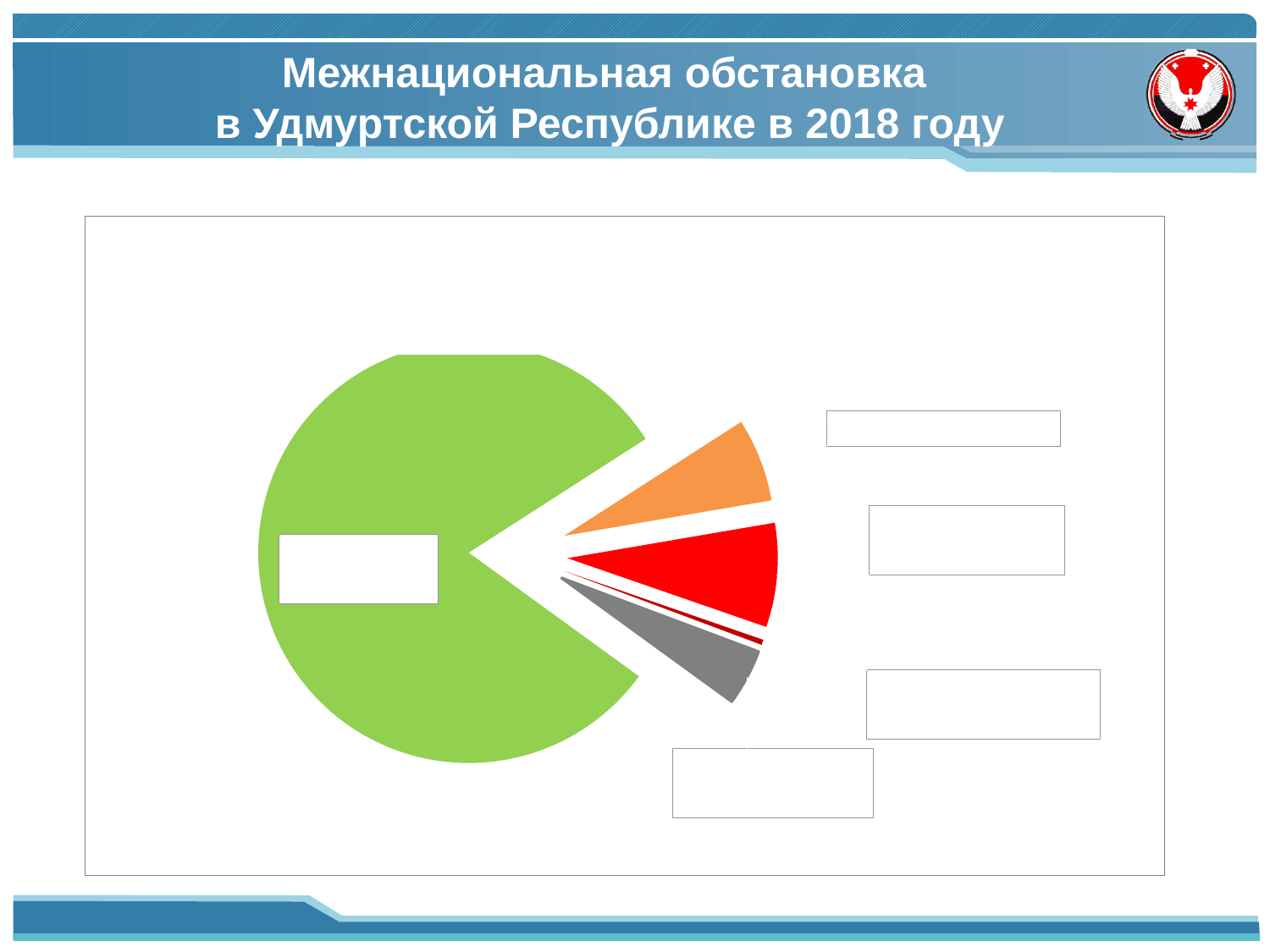
Which year does the slide title say the data refers to? 2018 What is the title of the slide containing the pie chart? Межнациональная обстановка в Удмуртской Республике в 2018 году Does the green slice take up more or less than half of the pie? more What kind of chart is shown on the slide? pie chart Which colour slice is the largest in the pie chart? green Is the green slice larger or smaller than the orange slice? larger Is the green slice larger or smaller than the red slice? larger